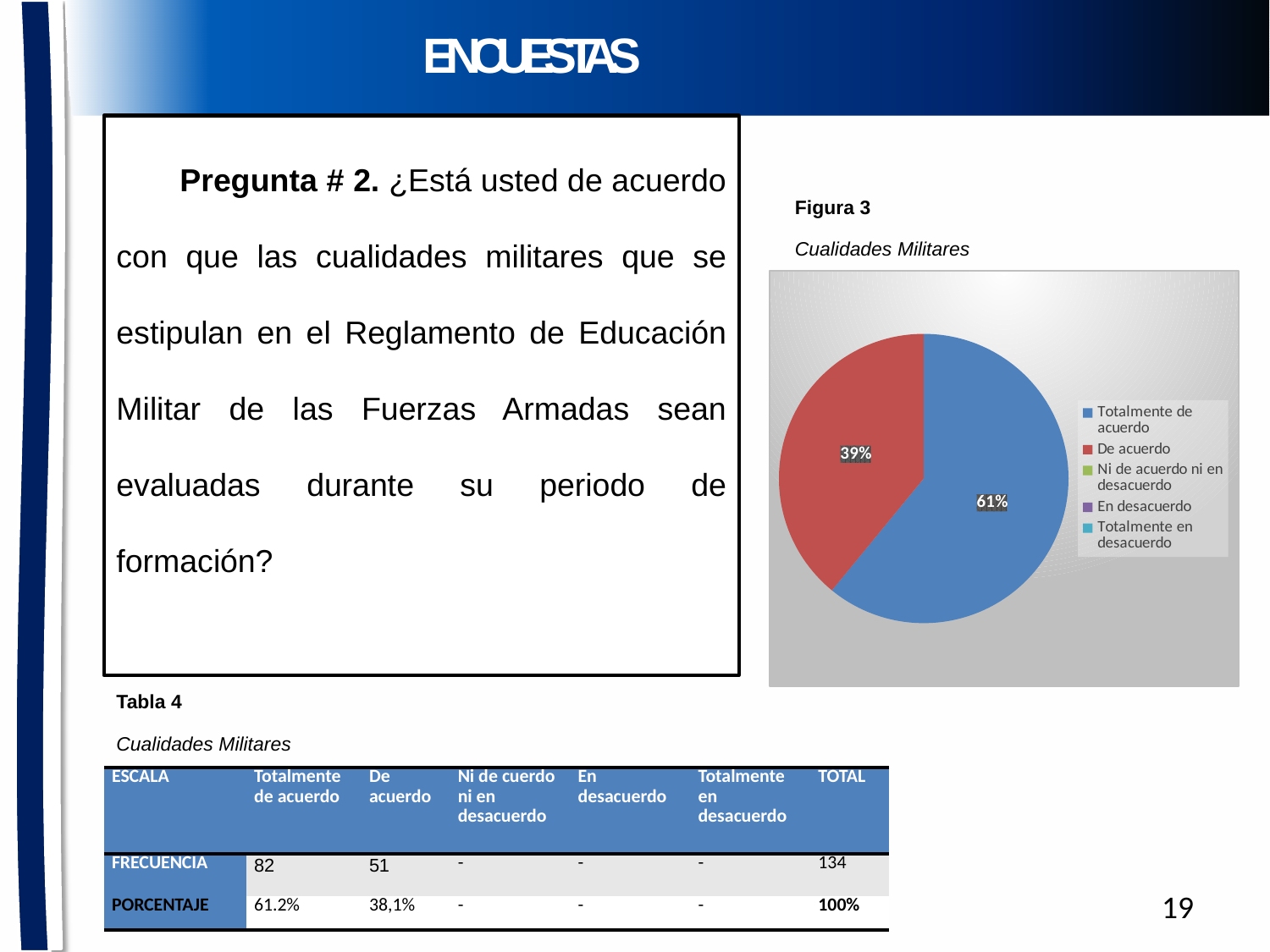
In the pie chart, what share is labelled for the 'De acuerdo' slice? 39% Which category has the largest slice in the pie chart? Totalmente de acuerdo In the pie chart, what share is labelled for the 'Totalmente de acuerdo' slice? 61% How many entries does the legend of the pie chart list? 5 How many slices with a visible percentage label does the pie chart show? 2 Is the 'Totalmente de acuerdo' slice greater or less than 50% of the pie? greater Is the 'Totalmente de acuerdo' slice larger or smaller than the 'De acuerdo' slice in the pie chart? larger Which of the two labelled slices in the pie chart is smaller, 'Totalmente de acuerdo' or 'De acuerdo'? De acuerdo What kind of chart is shown in Figura 3? pie chart What colour is the 'De acuerdo' slice in the pie chart? red By how many percentage points does the 'Totalmente de acuerdo' slice exceed the 'De acuerdo' slice in the pie chart? 22% What is the title of the chart in Figura 3? Cualidades Militares